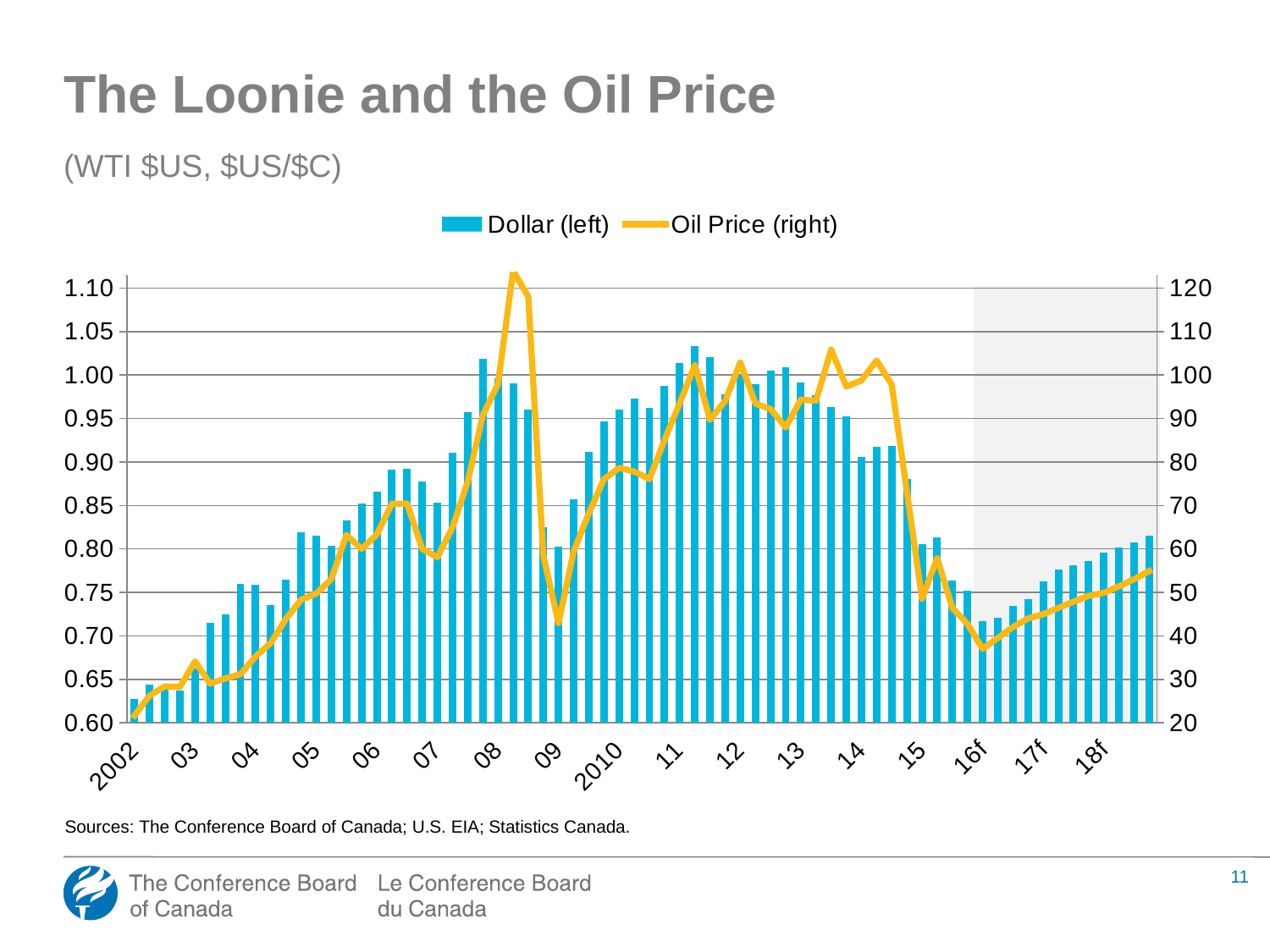
What are the two series named in the legend? Dollar (left) and Oil Price (right) Does the Dollar series rise or fall from 2002 to 2007? rise Does the Oil Price rise or fall from 2014 to 16f? fall How many series does the legend list? 2 Is the Dollar value at the start of 2002 greater or less than 0.65? less Is the Oil Price at its 2009 low greater or less than 50? less How many year labels are shown along the x axis? 17 What kind of chart is shown on the slide? A combined bar and line chart In which year does the Oil Price reach its highest point? 2008 Is the Dollar value at its 2011 peak greater or less than 1.00? greater What is the title of the chart? The Loonie and the Oil Price